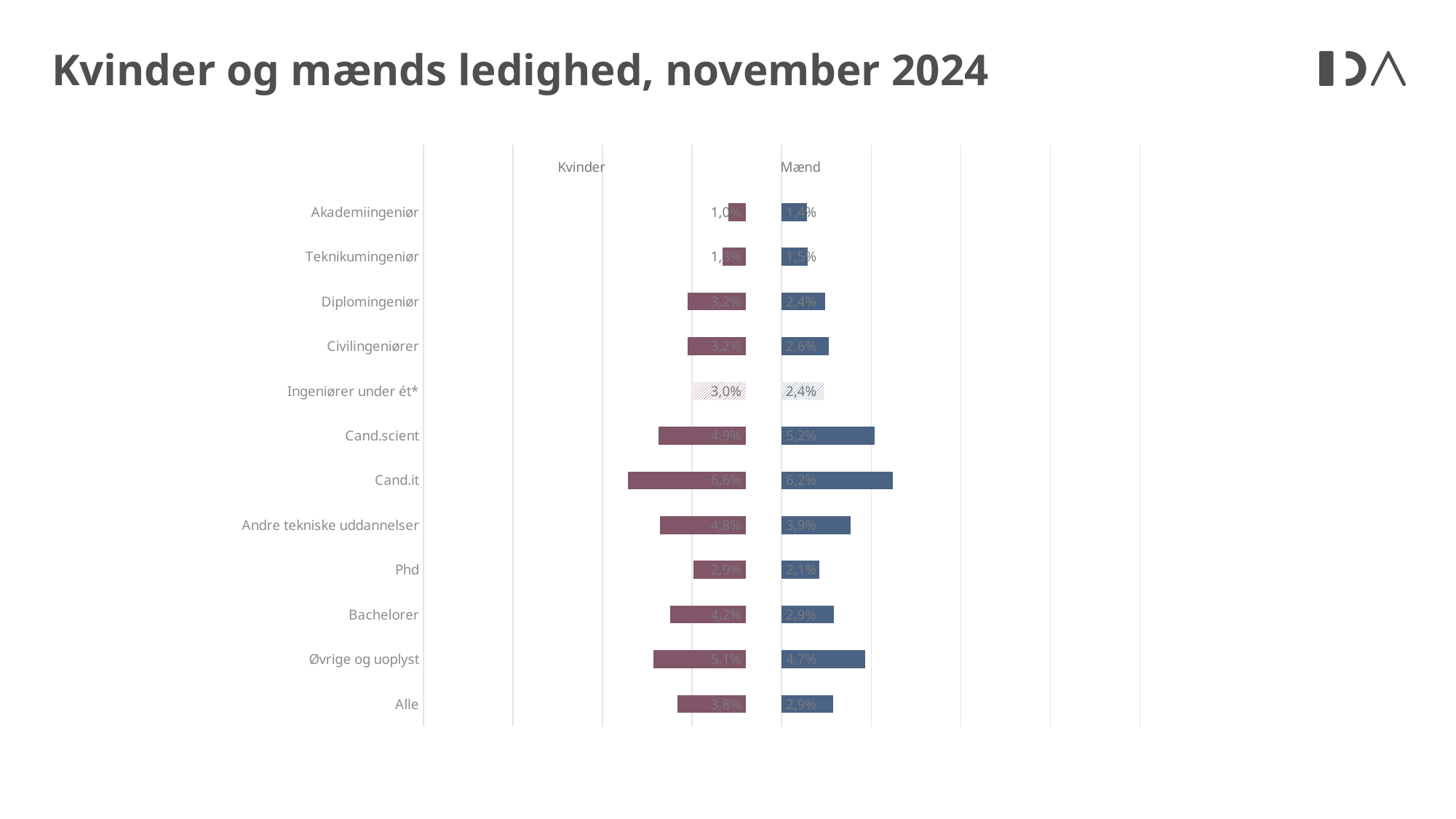
How many series does the chart show? 2 Which category has the highest Mænd value? Cand.it Which category has the lowest Kvinder value? Akademiingeniør What is the Kvinder value for Cand.it? 6,6% What is the Mænd value for Phd? 2,1% What is the Kvinder value for Alle? 3,8% For Andre tekniske uddannelser, which is larger: the Kvinder value or the Mænd value? Kvinder What type of chart is shown on the slide? Bar chart What is the Mænd value for Cand.scient? 5,2% What is the difference between the Kvinder and Mænd values for Bachelorer? 1,3% How many categories are shown on the chart? 12 Which category has the highest Kvinder value? Cand.it